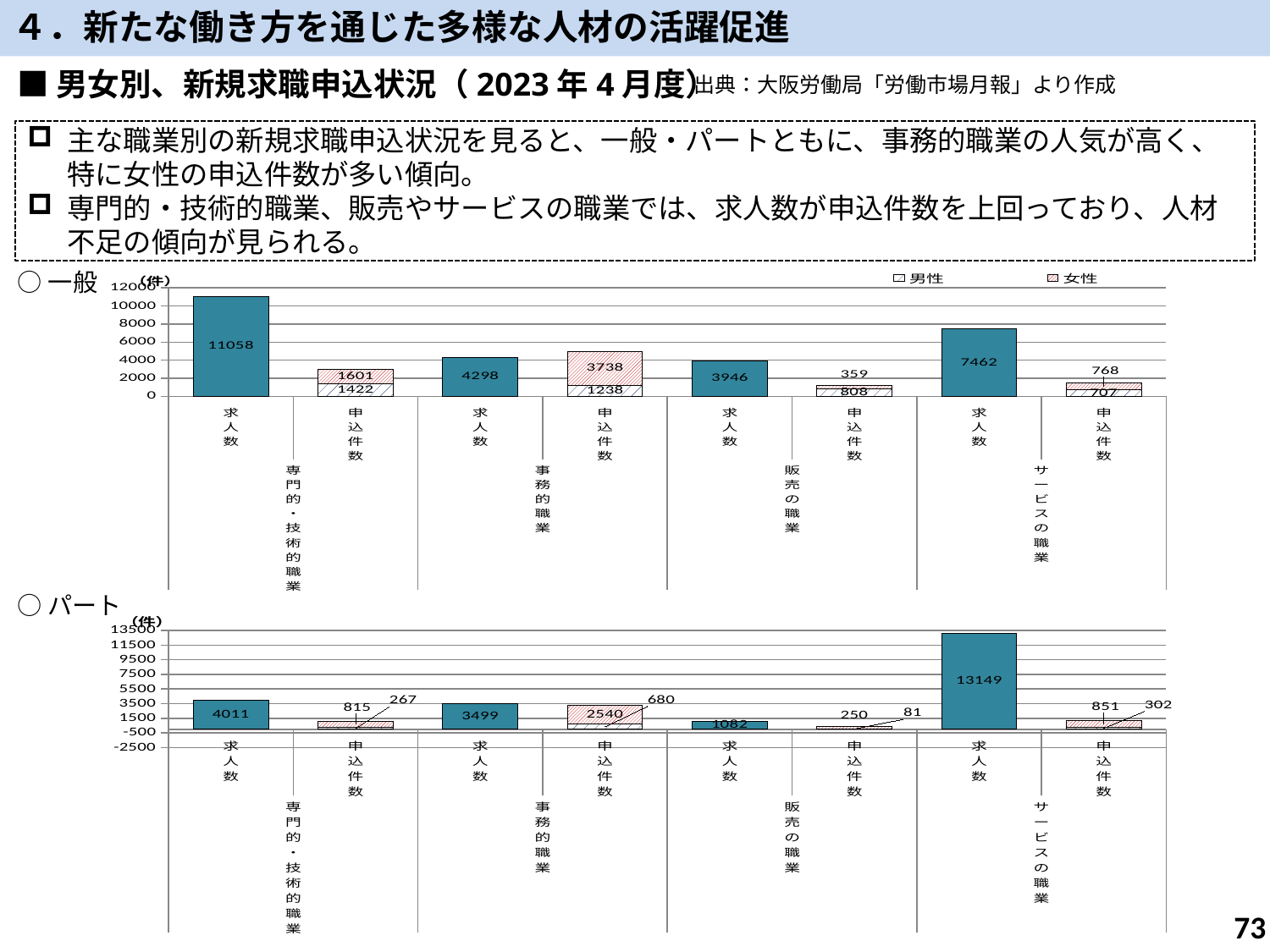
In the bottom chart (パート), which occupation has the lowest 求人数? 販売の職業 In the top chart (一般), which occupation has the highest 求人数? 専門的・技術的職業 In the top chart (一般), what is the total 申込件数 (男性 plus 女性) for 事務的職業? 4976 In the top chart (一般), what is the 男性 申込件数 for 販売の職業? 808 In the top chart (一般), what is the 求人数 for 専門的・技術的職業? 11058 In the top chart (一般), what is the difference between the 求人数 for 専門的・技術的職業 and the 求人数 for サービスの職業? 3596 In the bottom chart (パート), what is the total 申込件数 (男性 plus 女性) for 事務的職業? 3220 In the bottom chart (パート), what is the 求人数 for 事務的職業? 3499 In the top chart (一般), what is the 女性 申込件数 for 事務的職業? 3738 How many series does the legend of the top chart (一般) list? 2 In the bottom chart (パート), what is the 求人数 for サービスの職業? 13149 In the top chart (一般), for 事務的職業, which is larger: the 求人数 or the total 申込件数? 申込件数